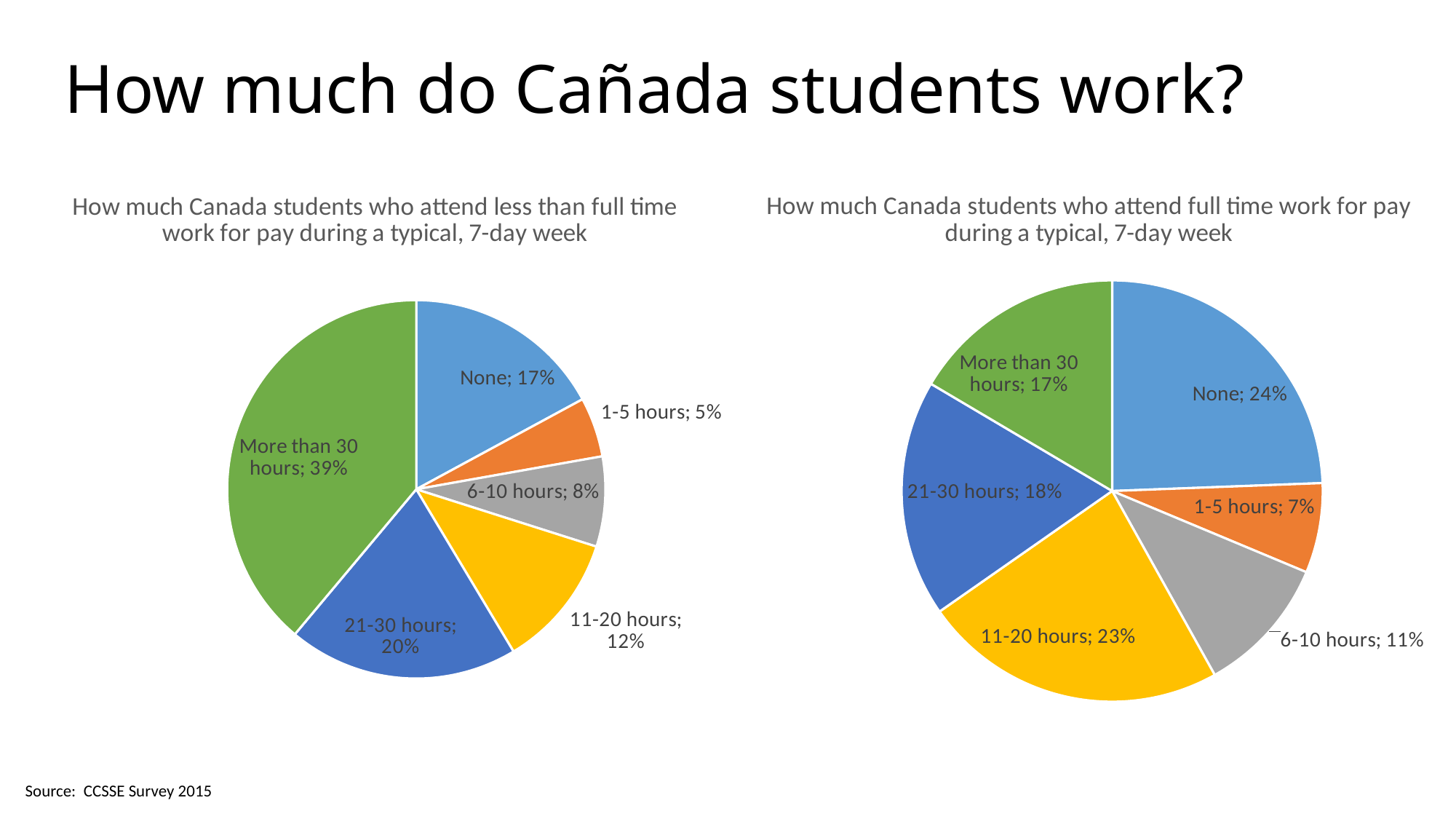
How many slices does the left pie chart (students who attend less than full time) have? 6 In the left pie chart (students who attend less than full time), which is larger: the share for 21-30 hours or the share for 11-20 hours? 21-30 hours In the right pie chart (students who attend full time), which category has the largest share? None What is the source cited at the bottom of the slide? CCSSE Survey 2015 In the right pie chart (students who attend full time), which category has the smallest share? 1-5 hours In the right pie chart (students who attend full time), what share of students work 11-20 hours? 23% In the right pie chart (students who attend full time), what share of students work 6-10 hours? 11% What type of chart is used on the slide? Pie chart In the left pie chart (students who attend less than full time), which category has the smallest share? 1-5 hours In the left pie chart (students who attend less than full time), what share of students work more than 30 hours? 39% In the left pie chart (students who attend less than full time), which category has the largest share? More than 30 hours In the right pie chart (students who attend full time), what is the difference between the share for None and the share for More than 30 hours? 7%